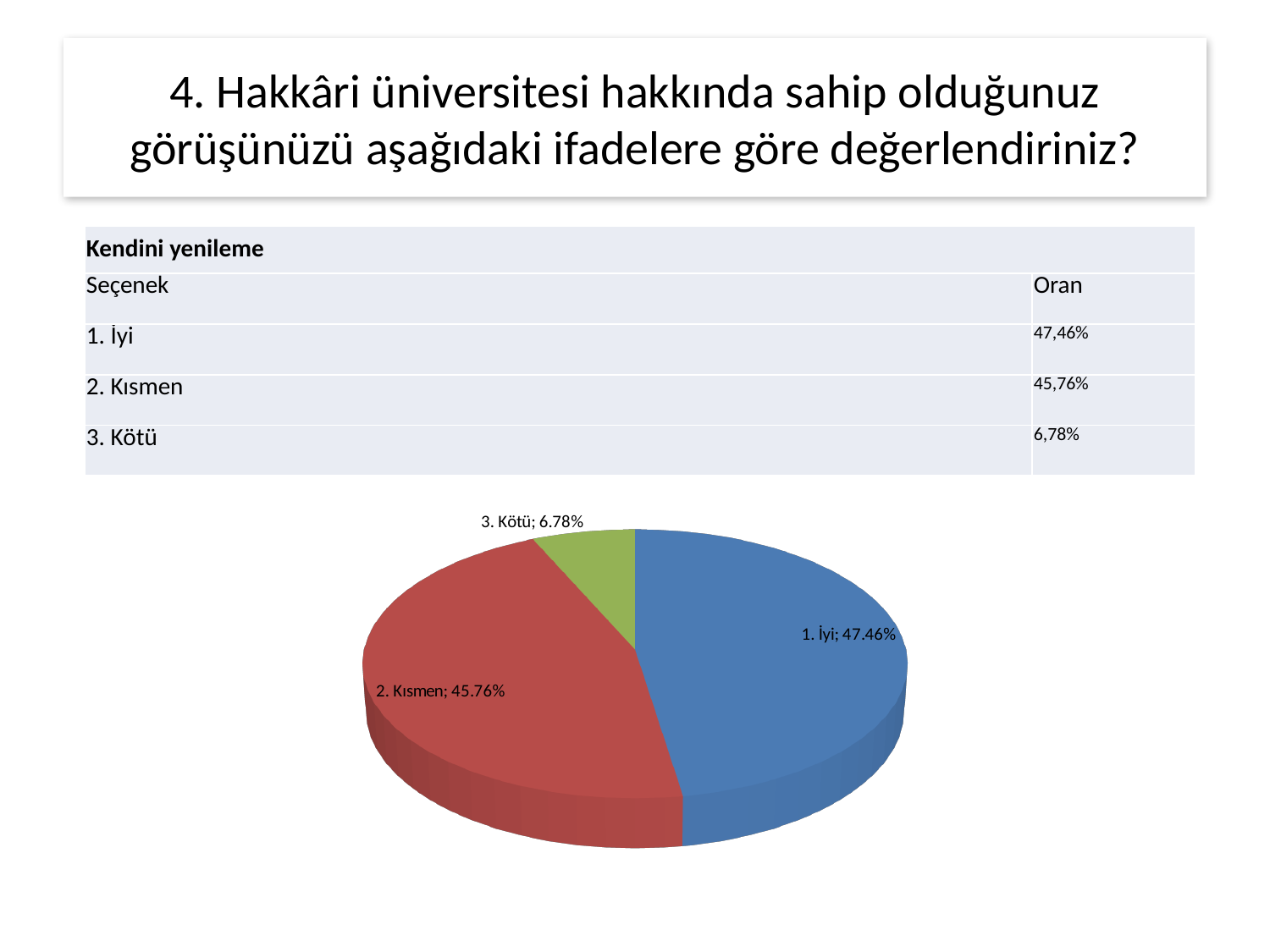
Which slice of the pie chart has the largest share? 1. İyi What colour is the slice for "2. Kısmen" in the pie chart? Red What is the difference between the shares for "1. İyi" and "2. Kısmen" in the pie chart? 1.70% What is the value shown for the slice labelled "3. Kötü" in the pie chart? 6.78% What is the difference between the shares for "2. Kısmen" and "3. Kötü" in the pie chart? 38.98% Which is larger in the pie chart, the share for "1. İyi" or the share for "2. Kısmen"? 1. İyi What colour is the slice for "3. Kötü" in the pie chart? Green How many slices does the pie chart have? 3 Which slice of the pie chart has the smallest share? 3. Kötü What is the value shown for the slice labelled "1. İyi" in the pie chart? 47.46% What is the value shown for the slice labelled "2. Kısmen" in the pie chart? 45.76% What kind of chart is shown on the slide? Pie chart